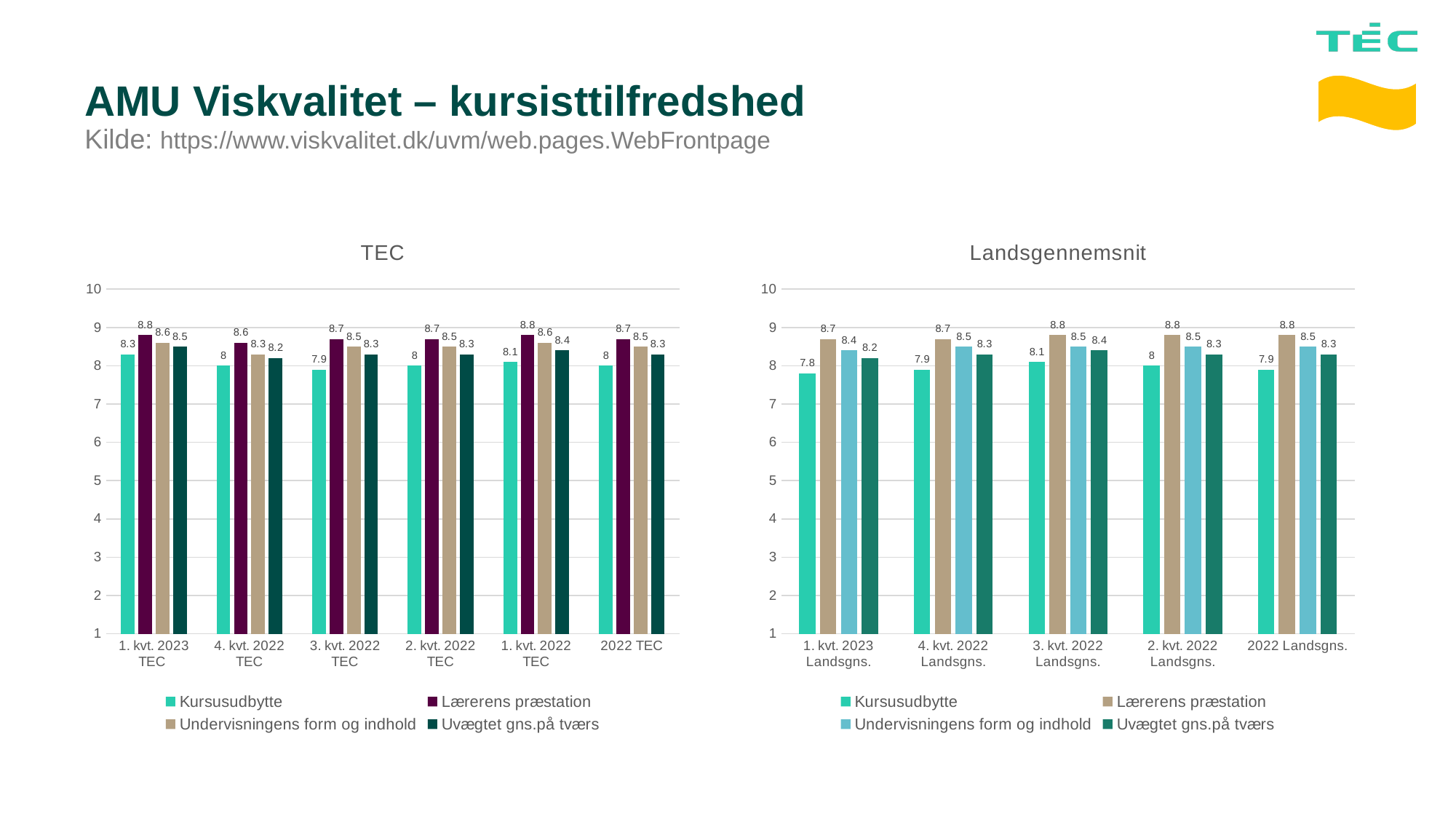
In the Landsgennemsnit chart, what is the value of Uvægtet gns.på tværs for 3. kvt. 2022 Landsgns.? 8.4 In the Landsgennemsnit chart, what is the difference between Lærerens præstation and Kursusudbytte for 1. kvt. 2023 Landsgns.? 0.9 In the TEC chart, what is the value of Kursusudbytte for 1. kvt. 2023 TEC? 8.3 In the TEC chart, which category has the lowest Kursusudbytte value? 3. kvt. 2022 TEC In the Landsgennemsnit chart, what is the value of Kursusudbytte for 1. kvt. 2023 Landsgns.? 7.8 How many series does the legend of the Landsgennemsnit chart list? 4 In the TEC chart, what is the value of Lærerens præstation for 4. kvt. 2022 TEC? 8.6 Which is larger: Kursusudbytte for 1. kvt. 2023 in the TEC chart or in the Landsgennemsnit chart? TEC chart What type of chart is the TEC chart? Bar chart How many categories are shown on the x axis of the TEC chart? 6 In the TEC chart, what is the difference between Lærerens præstation and Kursusudbytte for 1. kvt. 2023 TEC? 0.5 How many categories are shown on the x axis of the Landsgennemsnit chart? 5